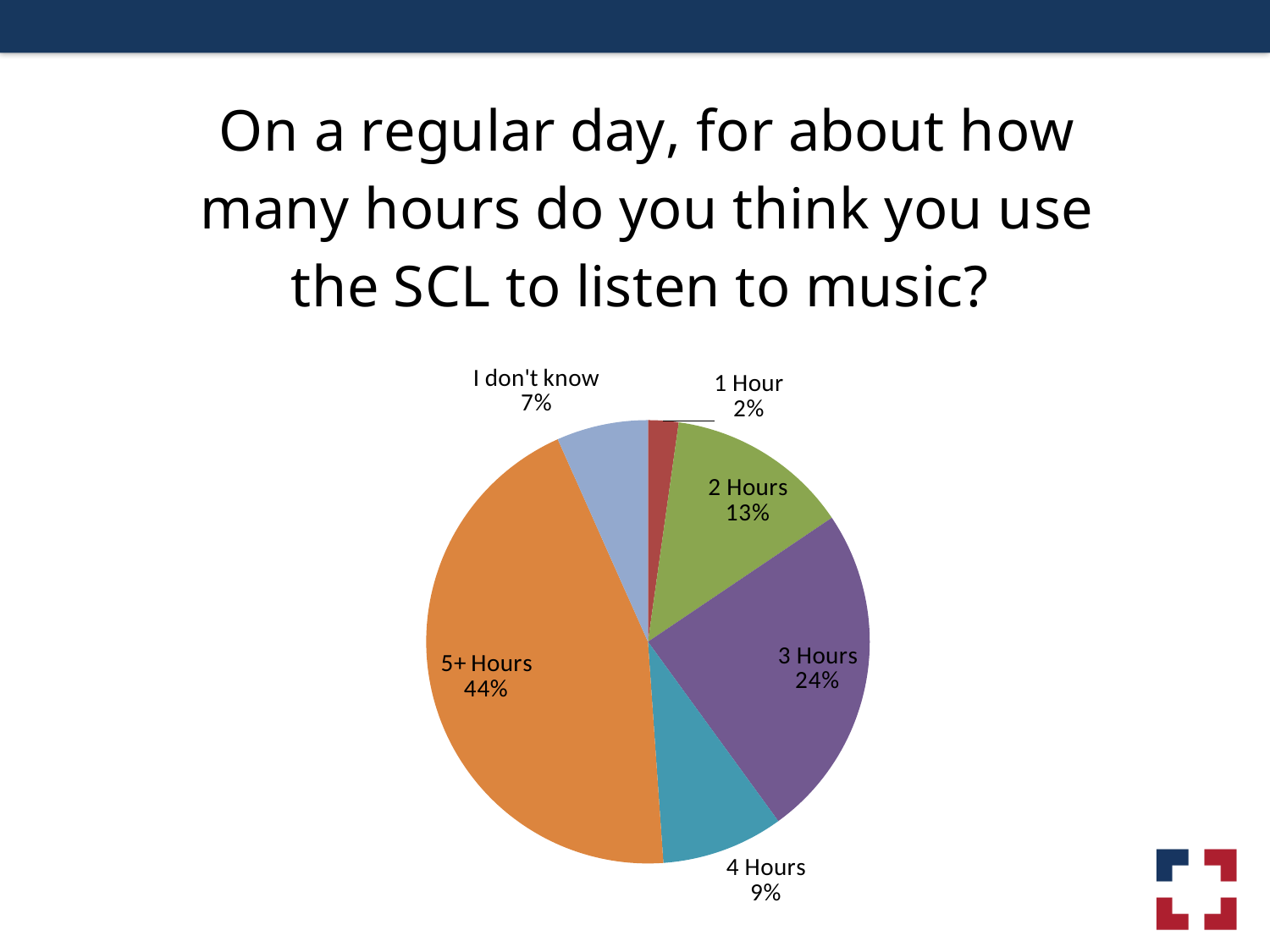
What share of the pie is labelled 3 Hours? 24% Which category has the smallest slice of the pie? 1 Hour What percentage is shown for the 2 Hours slice? 13% What kind of chart is shown on the slide? Pie chart Which is larger, the 4 Hours slice or the 2 Hours slice? 2 Hours What percentage of respondents answered 'I don't know'? 7% How many categories are shown in the pie chart? 6 What colour is the 5+ Hours slice? Orange Which category has the largest slice of the pie? 5+ Hours What is the combined percentage of the 1 Hour and 2 Hours slices? 15% What percentage of respondents said they use the SCL to listen to music for 5+ hours? 44% What is the difference in percentage points between the 5+ Hours slice and the 3 Hours slice? 20